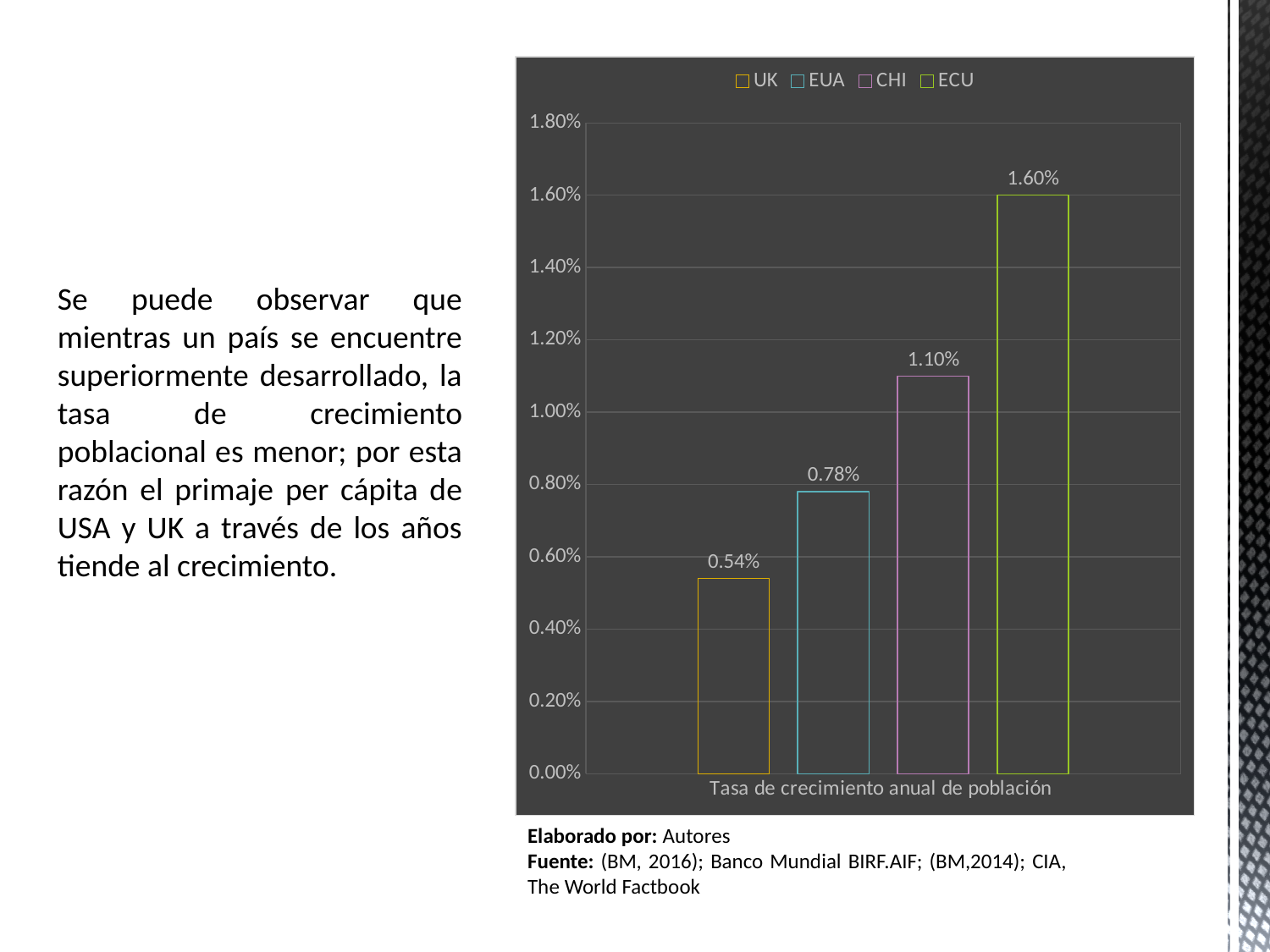
How many series does the legend list? 4 What is the difference between the growth rates of ECU and UK? 1.06% What is the annual population growth rate shown for EUA? 0.78% Which country has the lowest annual population growth rate in the chart? UK Which has a higher growth rate, EUA or CHI? CHI What is the annual population growth rate shown for CHI? 1.10% What is the annual population growth rate shown for ECU? 1.60% What is the annual population growth rate shown for UK? 0.54% What is the label shown on the x axis of the chart? Tasa de crecimiento anual de población What kind of chart is shown on the slide? Bar chart Which country has the highest annual population growth rate in the chart? ECU What is the difference between the growth rates of CHI and EUA? 0.32%